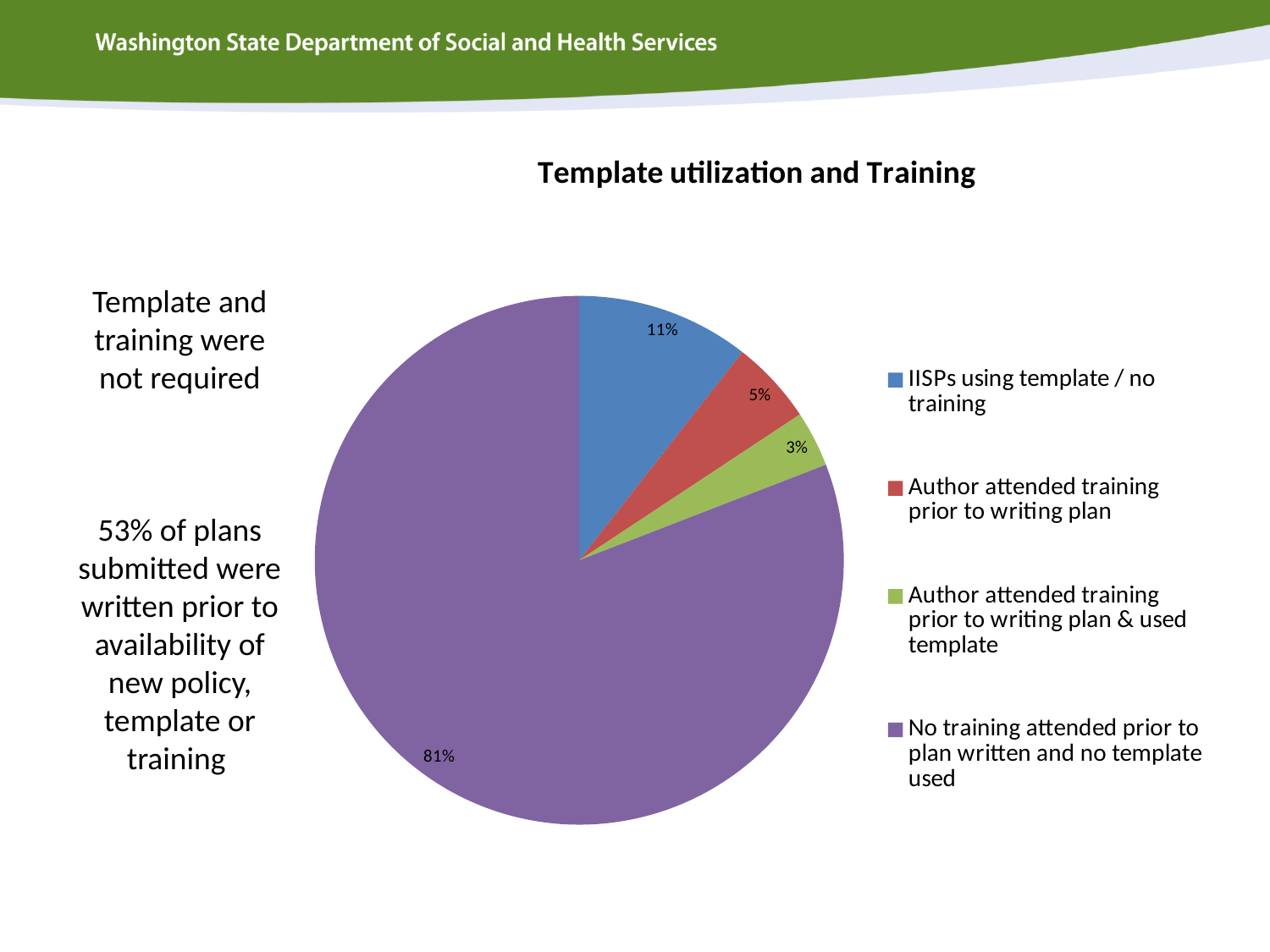
What colour is the slice for 'No training attended prior to plan written and no template used'? purple Which is larger: the slice for 'IISPs using template / no training' or the slice for 'Author attended training prior to writing plan'? IISPs using template / no training What is the title of the chart? Template utilization and Training What share of the pie is 'No training attended prior to plan written and no template used'? 81% What share of the pie is 'Author attended training prior to writing plan'? 5% What kind of chart is shown on the slide? pie chart How many categories does the pie chart show? 4 Which category has the largest slice of the pie? No training attended prior to plan written and no template used What is the difference in percentage points between 'IISPs using template / no training' and 'Author attended training prior to writing plan'? 6% What share of the pie is 'Author attended training prior to writing plan & used template'? 3% Which category has the smallest slice of the pie? Author attended training prior to writing plan & used template